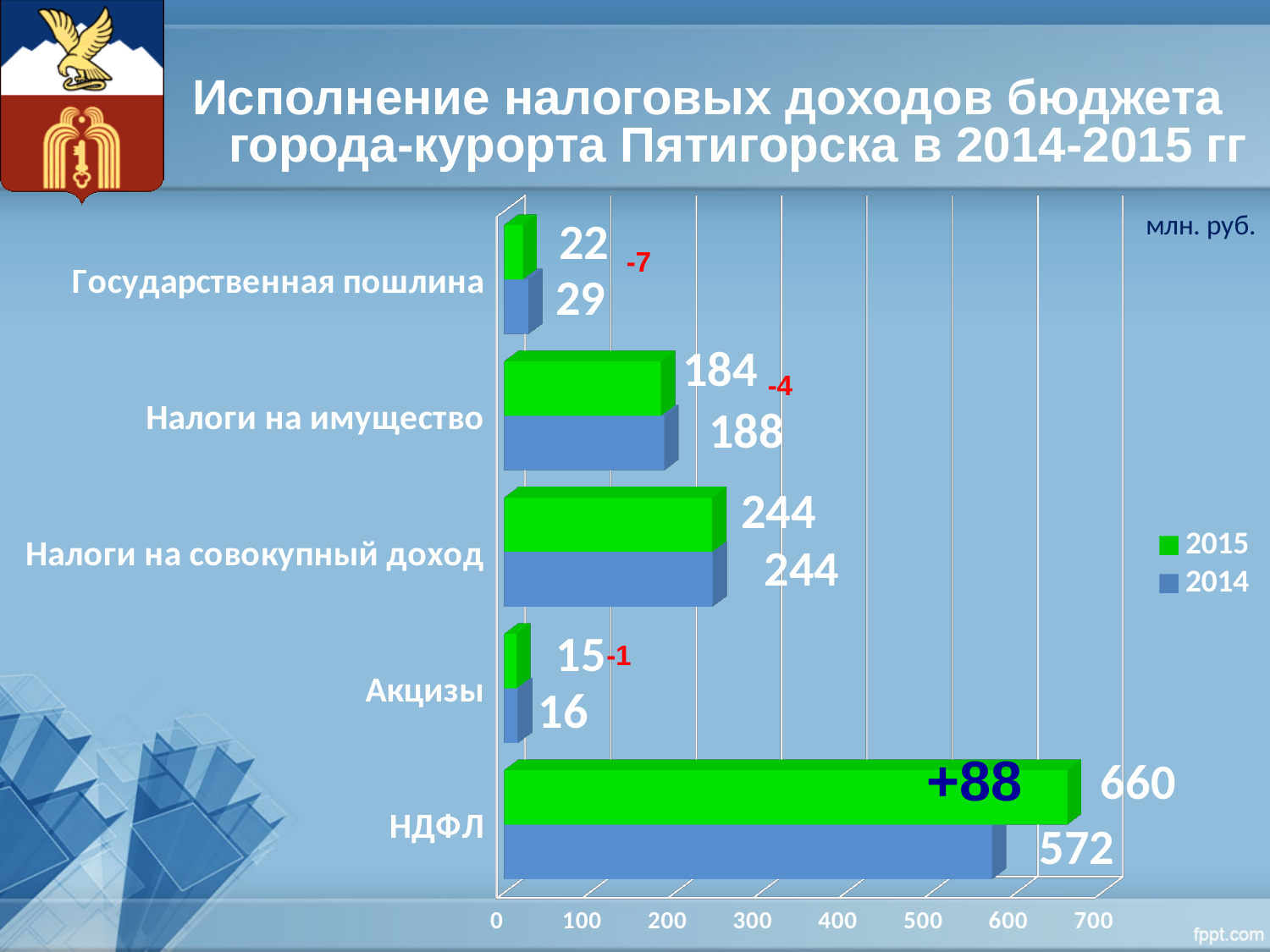
Which category has the lowest 2014 value? Акцизы Which category has the highest 2015 value? НДФЛ What is the 2014 value for Налоги на имущество? 188 How many series does the legend list? 2 What is the difference between the 2015 and 2014 values for НДФЛ? 88 Which is larger for Налоги на имущество: the 2015 value or the 2014 value? 2014 What kind of chart is shown on the slide? Bar chart What is the 2014 value for Акцизы? 16 What is the 2015 value for Государственная пошлина? 22 How many categories are shown on the chart? 5 What unit is indicated in the top right corner of the chart? млн. руб. What is the 2015 value for НДФЛ? 660